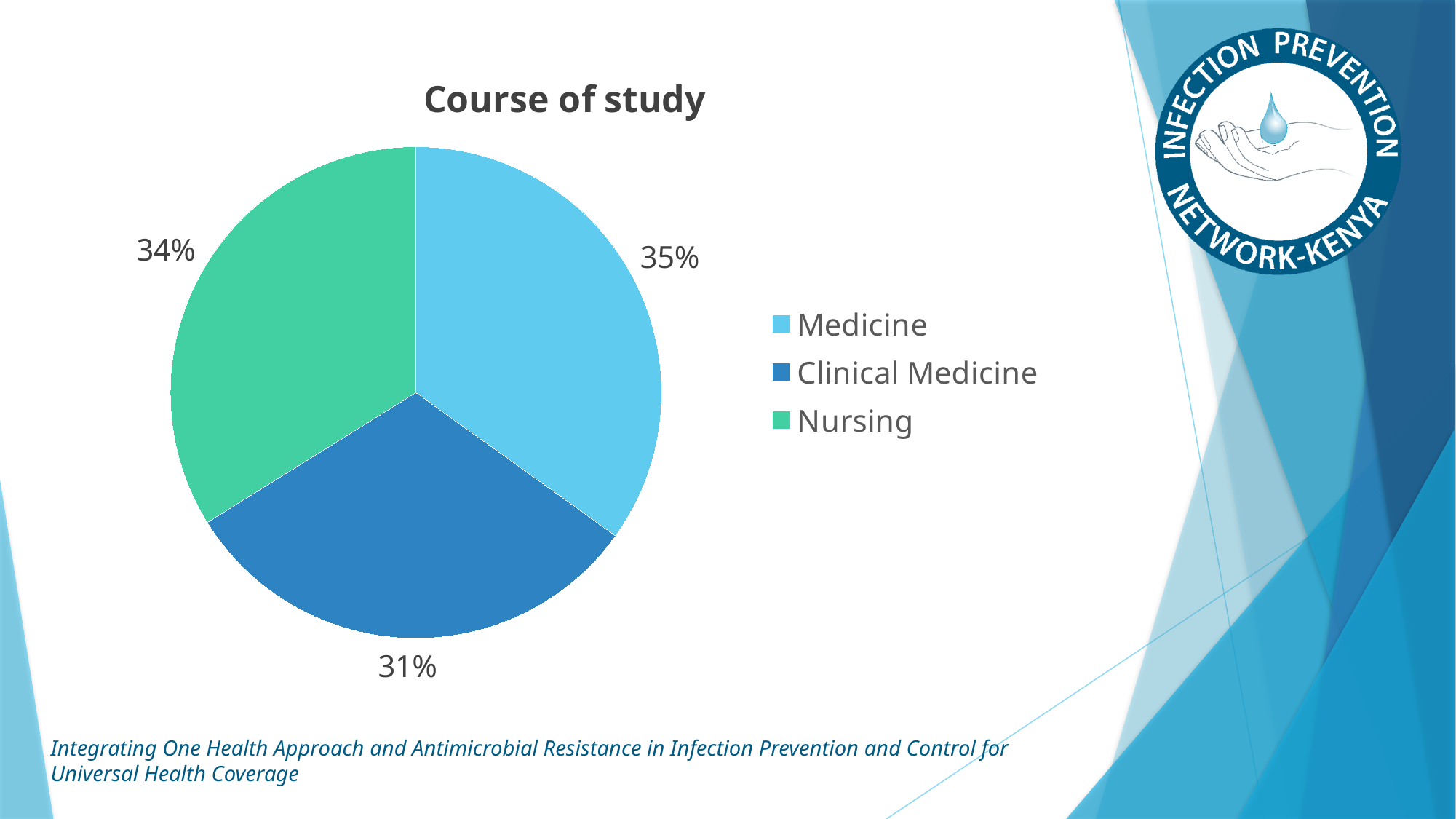
Which course of study has the smallest share of the pie? Clinical Medicine What share of the pie does Nursing represent? 34% What kind of chart is shown on the slide? pie chart What share of the pie does Medicine represent? 35% Which colour represents Nursing in the pie chart? green Which course of study has the largest share of the pie? Medicine What is the title of the chart? Course of study How many categories does the pie chart show? 3 What share of the pie does Clinical Medicine represent? 31% What is the difference in percentage points between the Nursing and Clinical Medicine slices? 3 What is the difference in percentage points between the Medicine and Clinical Medicine slices? 4 Is the share for Clinical Medicine greater or less than the share for Nursing? less